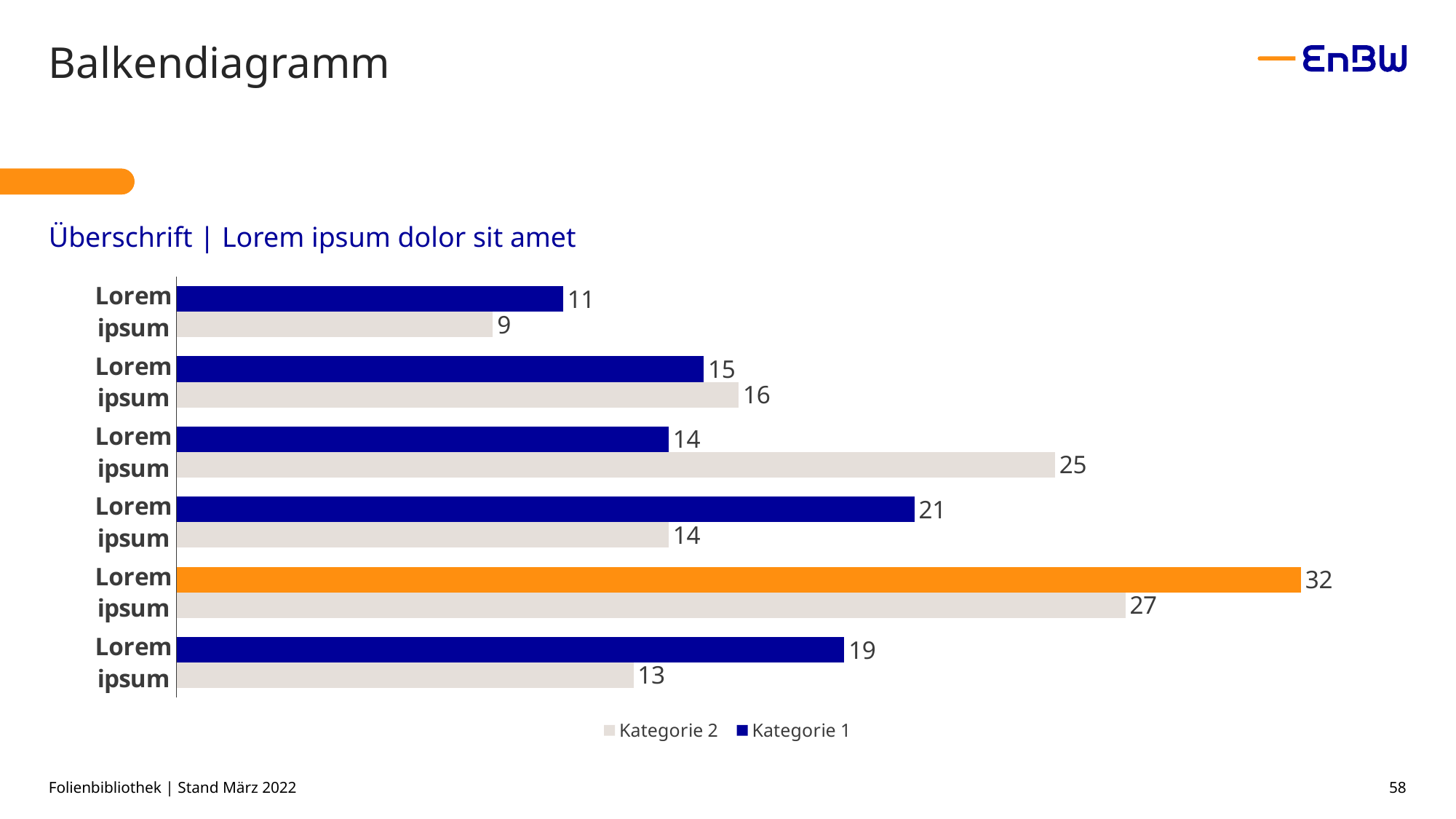
What is the value of the Kategorie 2 bar in the third group from the top? 25 What is the value of the Kategorie 2 bar in the bottom group? 13 What is the highest value shown for Kategorie 1? 32 What is the lowest value shown for Kategorie 2? 9 In the fourth group from the top, which series has the larger value, Kategorie 1 or Kategorie 2? Kategorie 1 How many category groups are plotted on the chart? 6 What are the two series names listed in the legend? Kategorie 2 and Kategorie 1 What kind of chart is shown on the slide? bar chart How many series does the legend list? 2 In the fifth group from the top, what is the difference between the Kategorie 1 value and the Kategorie 2 value? 5 Which bar is highlighted in orange instead of blue? The Kategorie 1 bar in the fifth group (value 32) What is the value of the Kategorie 1 bar in the topmost group? 11